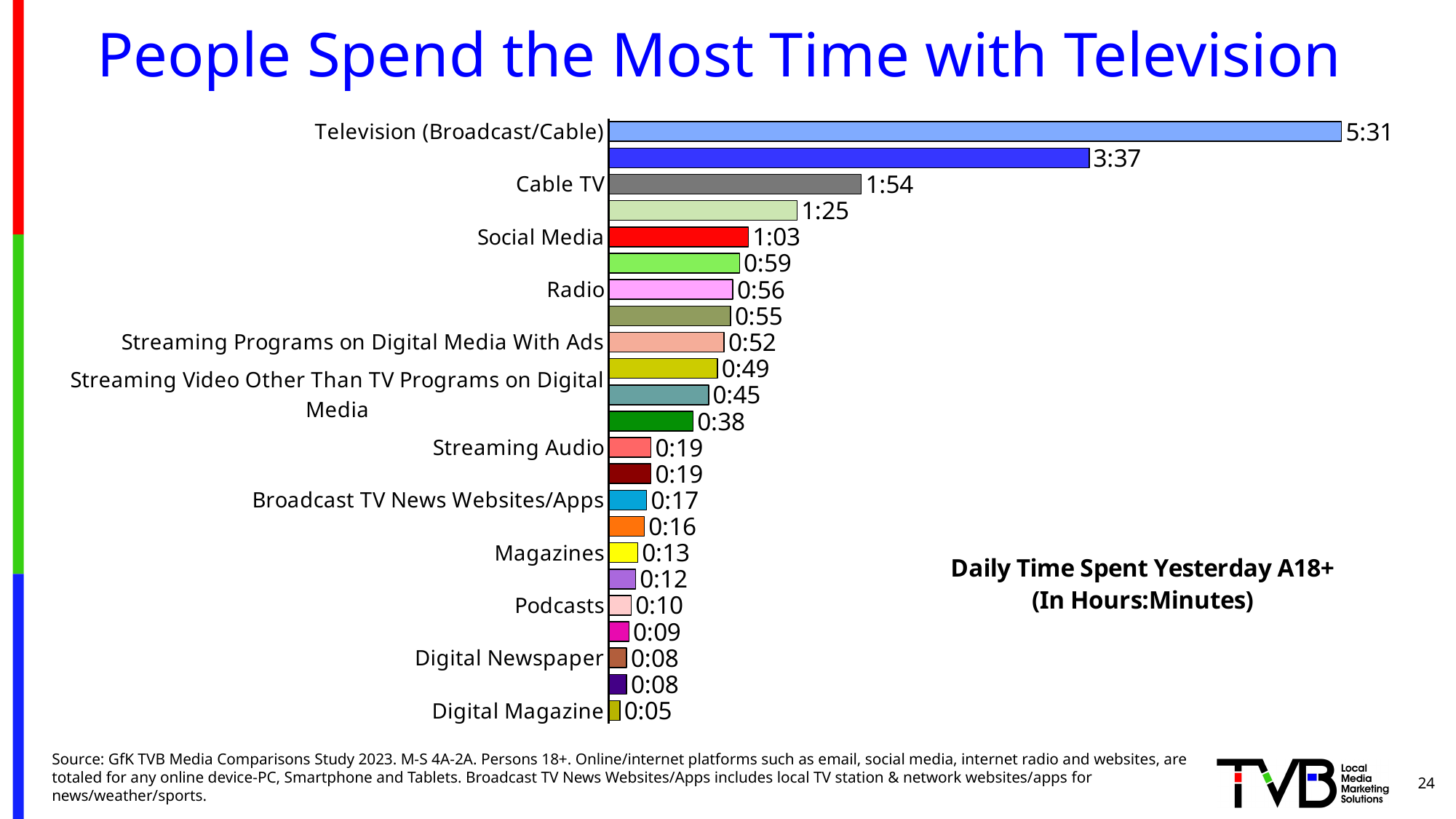
What is the daily time spent with Radio? 0:56 What is the daily time spent with Cable TV? 1:54 What unit does the chart's subtitle say the values are in? Hours:Minutes What is the daily time spent with Digital Magazine? 0:05 What is the daily time spent with Social Media? 1:03 Which category has the highest daily time spent? Television (Broadcast/Cable) What kind of chart is shown on the slide? Bar chart What is the daily time spent with Television (Broadcast/Cable)? 5:31 Which category has the lowest daily time spent? Digital Magazine What is the daily time spent with Podcasts? 0:10 Which has more daily time spent, Streaming Audio or Magazines? Streaming Audio How many minutes more are spent with Social Media than with Radio? 7 minutes